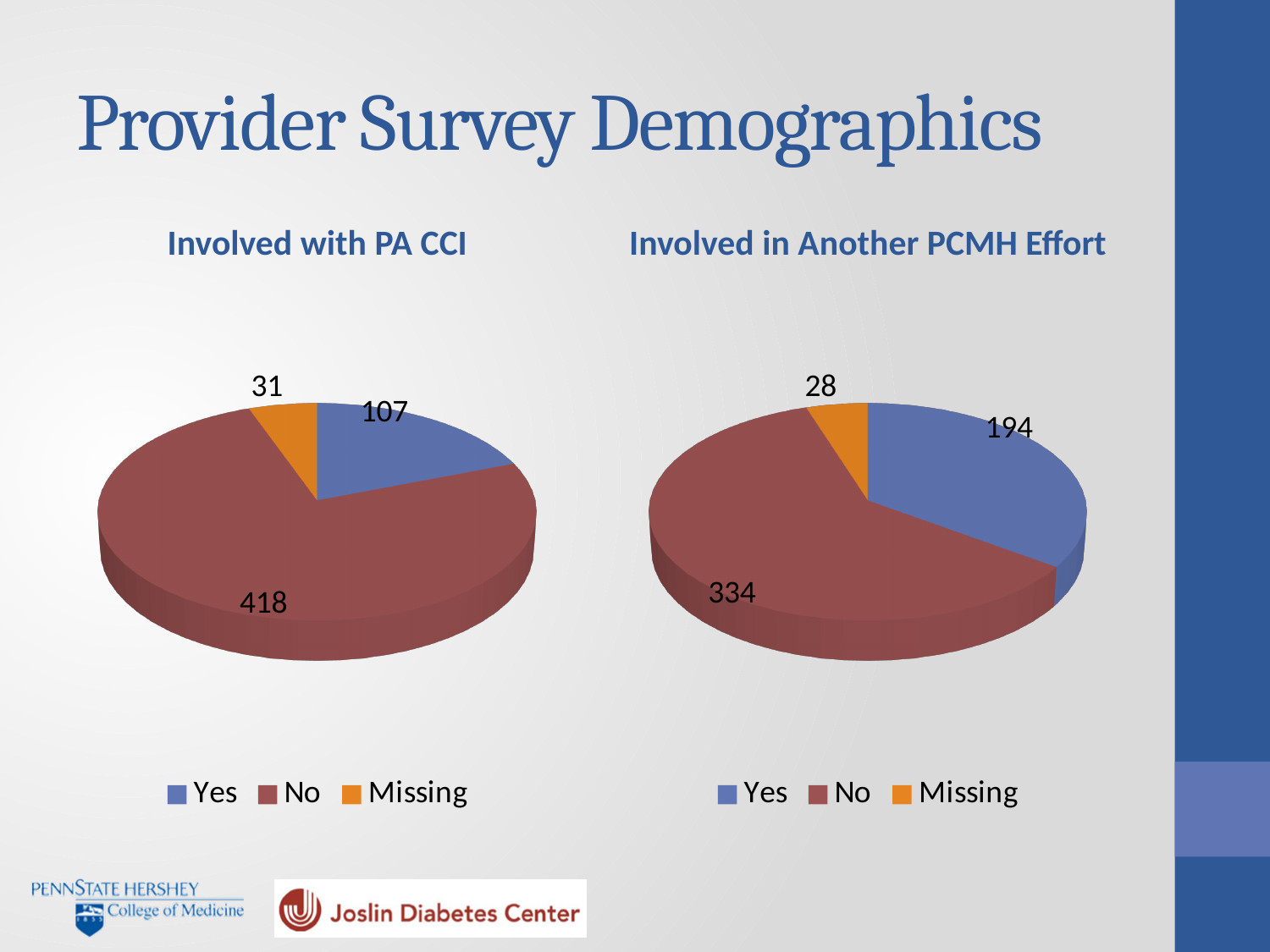
In the 'Involved in Another PCMH Effort' chart, what is the value for No? 334 In the 'Involved with PA CCI' chart, what is the value for Missing? 31 In the 'Involved in Another PCMH Effort' chart, what is the value for Yes? 194 In the 'Involved with PA CCI' chart, what colour represents the Missing category? Orange In the 'Involved with PA CCI' chart, what is the value for No? 418 Which chart has the larger Yes value, 'Involved with PA CCI' or 'Involved in Another PCMH Effort'? Involved in Another PCMH Effort In the 'Involved with PA CCI' chart, which category has the largest slice? No What type of chart is used for 'Involved with PA CCI'? Pie chart In the 'Involved in Another PCMH Effort' chart, which category has the smallest slice? Missing How many categories does the legend of the 'Involved in Another PCMH Effort' chart list? 3 In the 'Involved in Another PCMH Effort' chart, what is the difference between the No and Yes values? 140 In the 'Involved with PA CCI' chart, what is the difference between the No and Yes values? 311